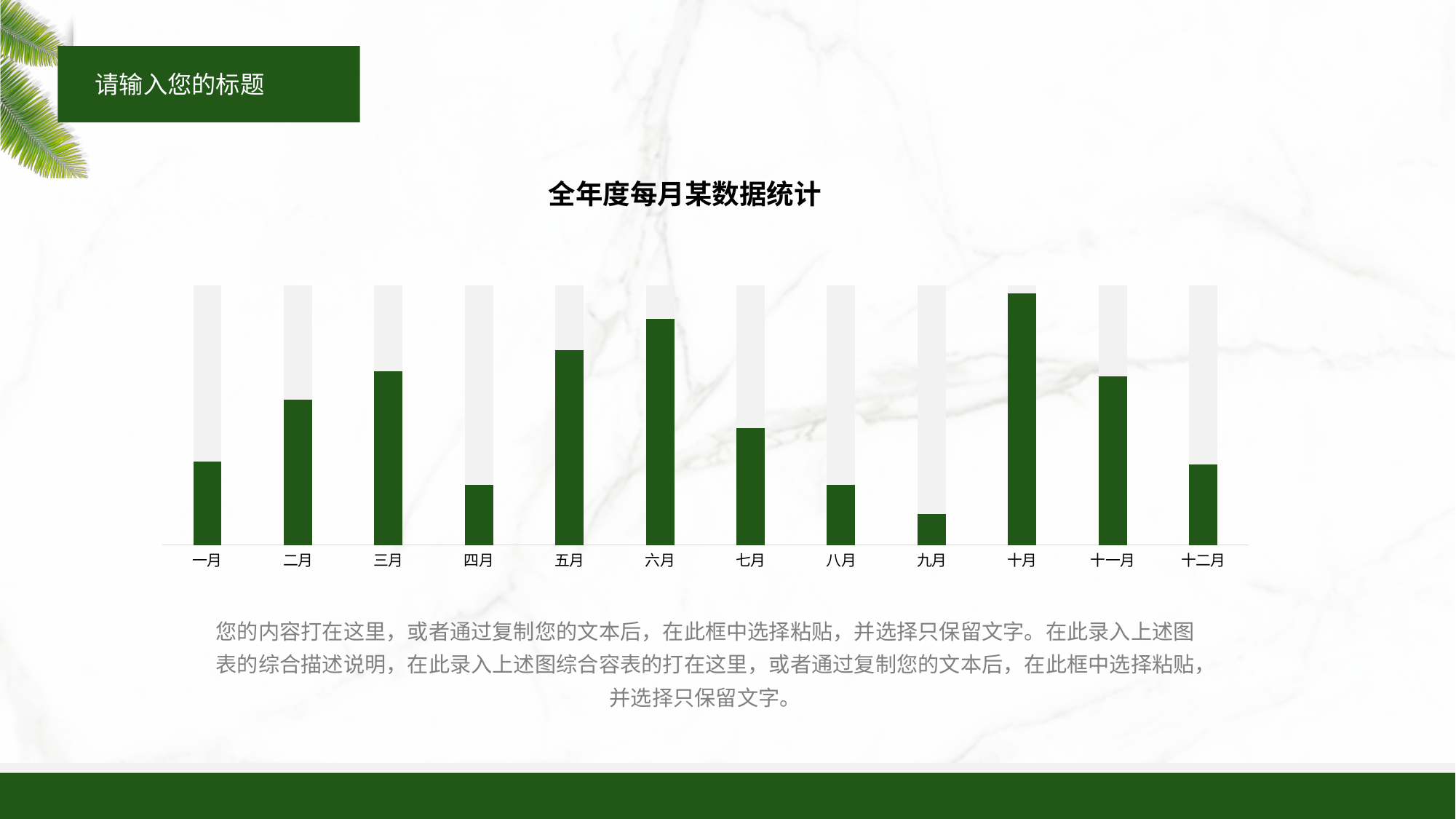
Which month has the lowest bar in the chart? 九月 Do the bars rise or fall from 一月 to 三月? rise What kind of chart is shown on the slide? bar chart What is the title of the chart? 全年度每月某数据统计 Do the bars rise or fall from 六月 to 九月? fall Which bar is taller, 二月 or 七月? 二月 Which bar is taller, 五月 or 六月? 六月 How many months (categories) are shown on the x axis of the chart? 12 Which month has the highest bar in the chart? 十月 Which bar is taller, 九月 or 十一月? 十一月 What colour are the data bars in the chart? dark green